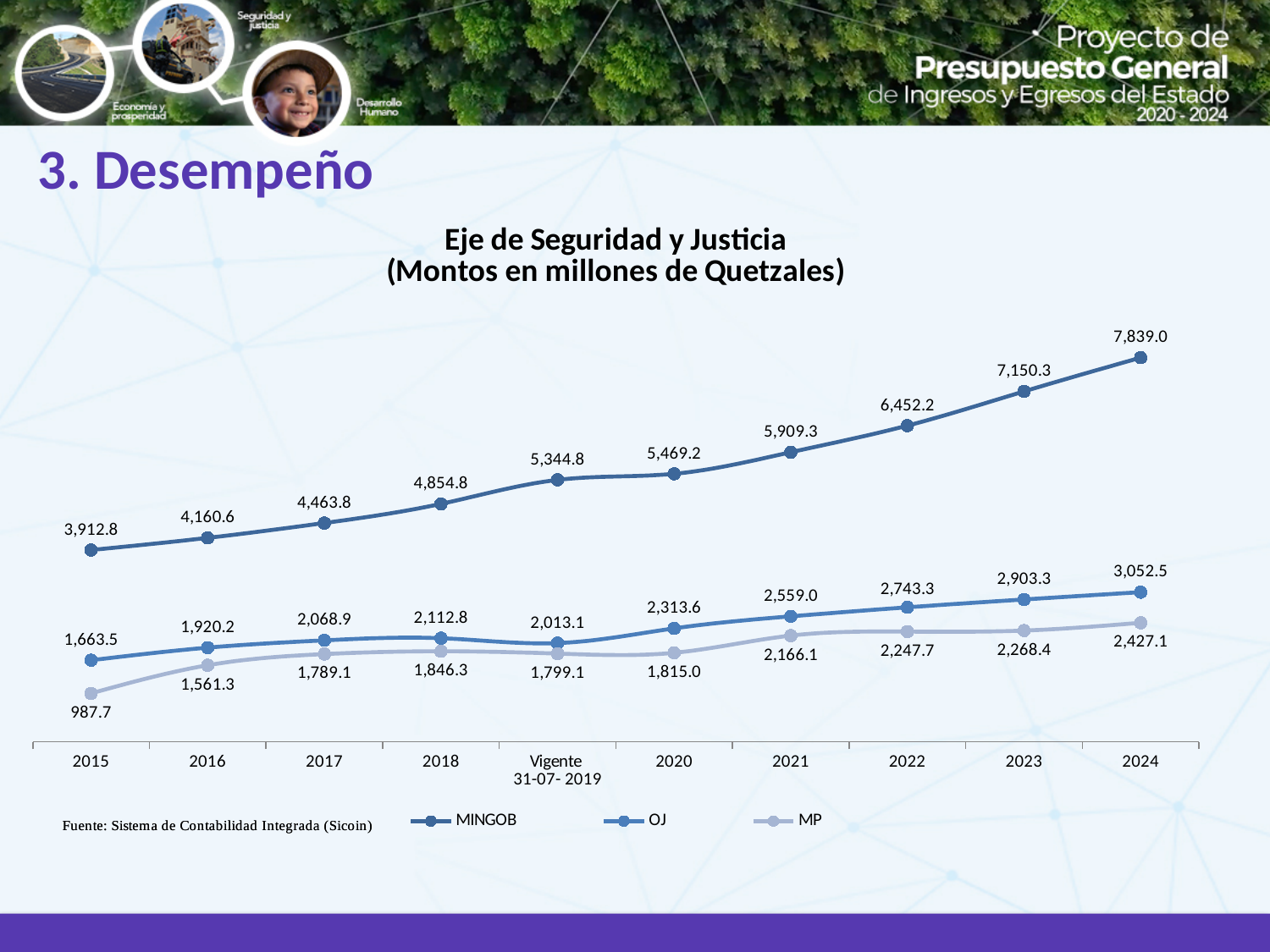
What is the value for MP in 2022? 2,247.7 What is the value for MINGOB in 2024? 7,839.0 In which year does the MINGOB series reach its highest value? 2024 In which year is the MP series at its lowest value? 2015 What kind of chart is shown on the slide? Line chart What is the value for OJ at Vigente 31-07-2019? 2,013.1 Does the MINGOB series rise or fall from 2015 to 2024? Rise What is the value for MP in 2015? 987.7 What is the difference between the MINGOB value in 2024 and in 2015? 3,926.2 Which series has the larger value in 2018, OJ or MP? OJ How many series does the legend list? 3 What is the difference between the OJ and MP values in 2024? 625.4